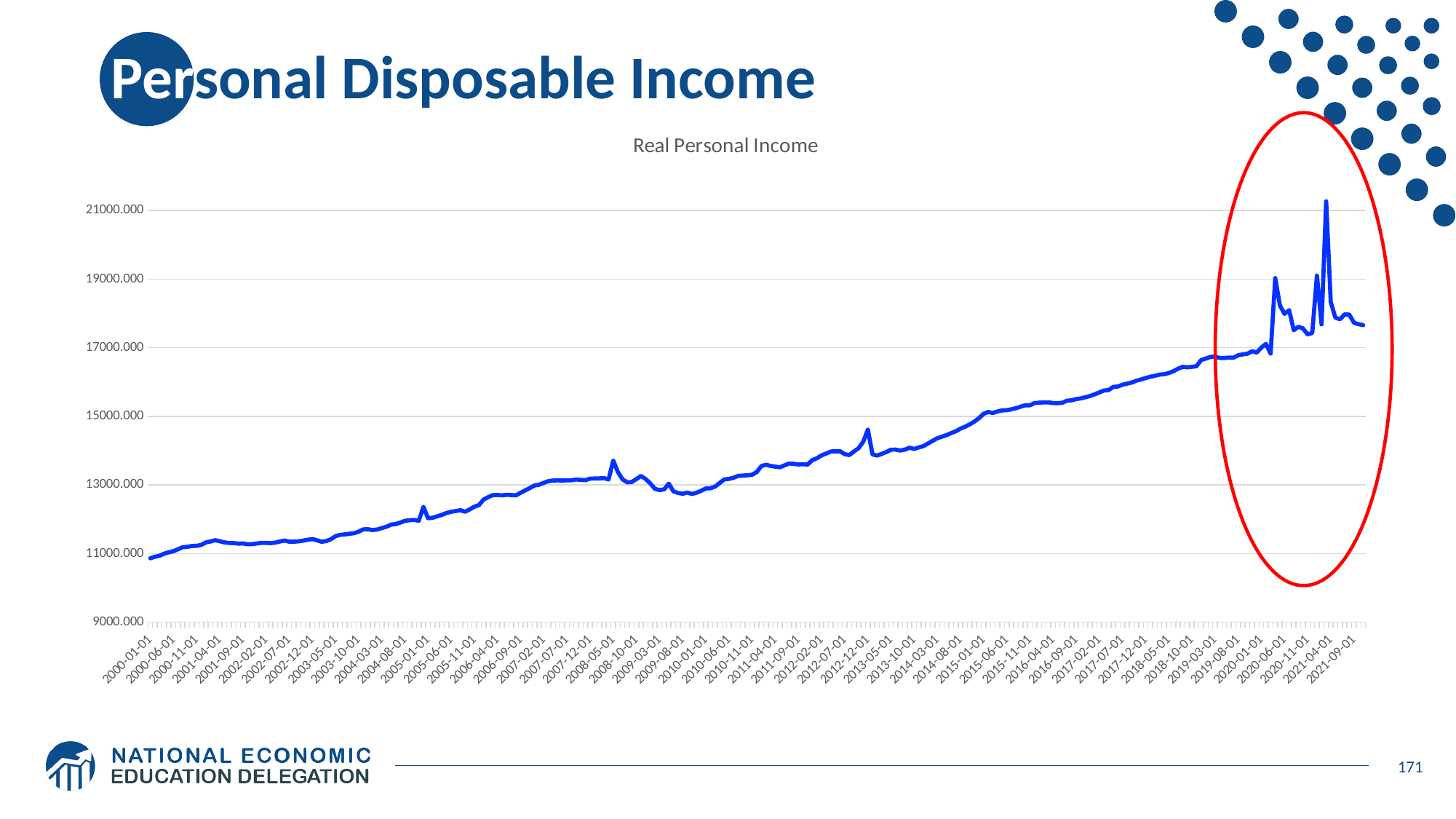
In which year does the line reach its highest value? 2021 Is the value for 2000-01-01 greater or less than 13000.000? less Is the value for 2007-12-01 greater or less than 15000.000? less Is the highest peak of the line in 2021 greater or less than 19000.000? greater What is the title of the chart? Real Personal Income Which is larger, the value for 2019-03-01 or the value for 2010-06-01? 2019-03-01 What colour is the plotted line? blue What kind of chart is shown on the slide? line chart Overall, does the Real Personal Income line rise or fall from 2000 to 2021? rise At which date does the line have its lowest value? 2000-01-01